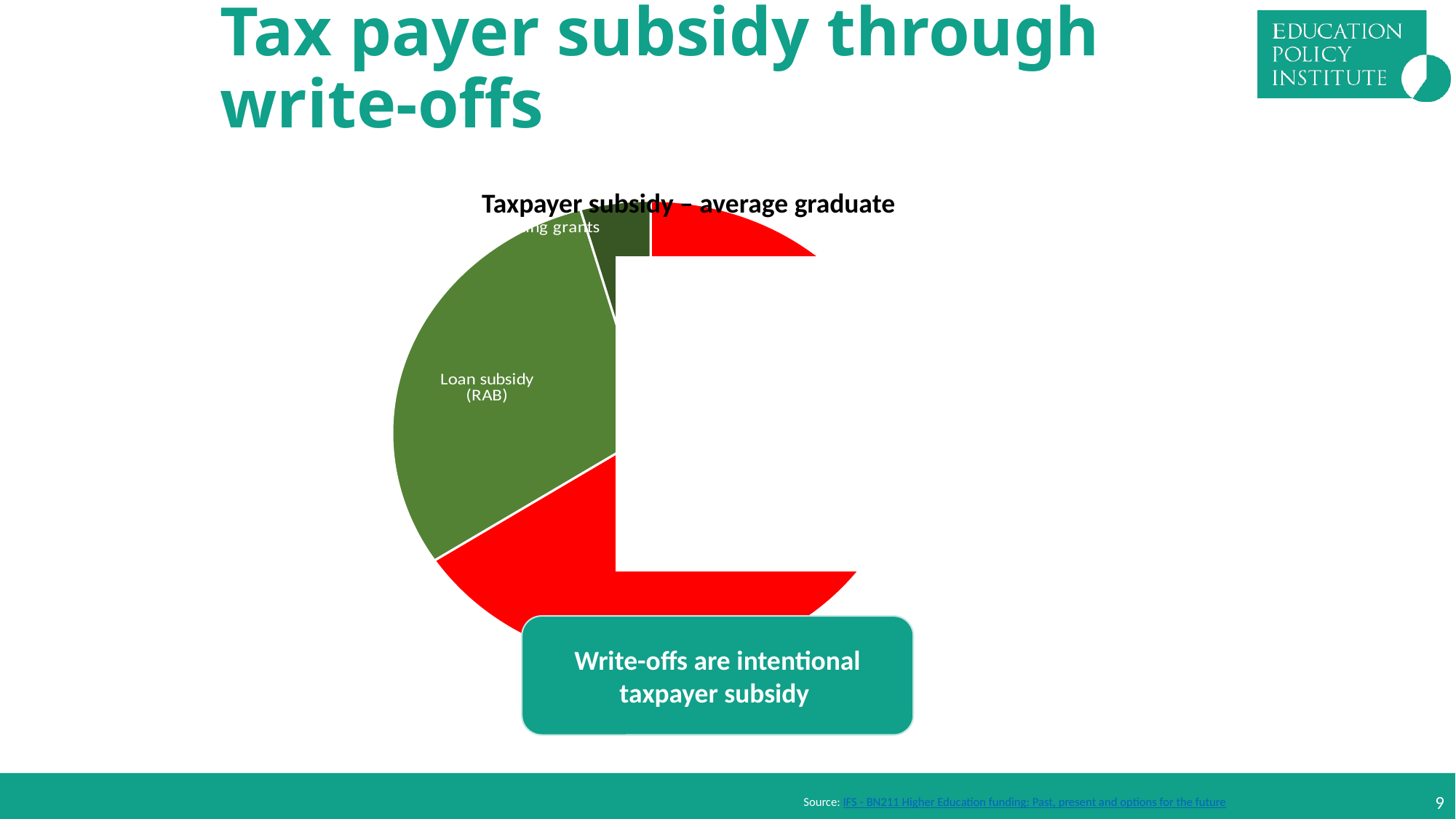
Which labelled slice of the pie chart is the largest? Loan subsidy (RAB) What kind of chart is shown under the title "Taxpayer subsidy – average graduate"? pie chart What is the title of the chart on the slide? Taxpayer subsidy – average graduate What colour is the "Loan subsidy (RAB)" slice of the pie chart? green